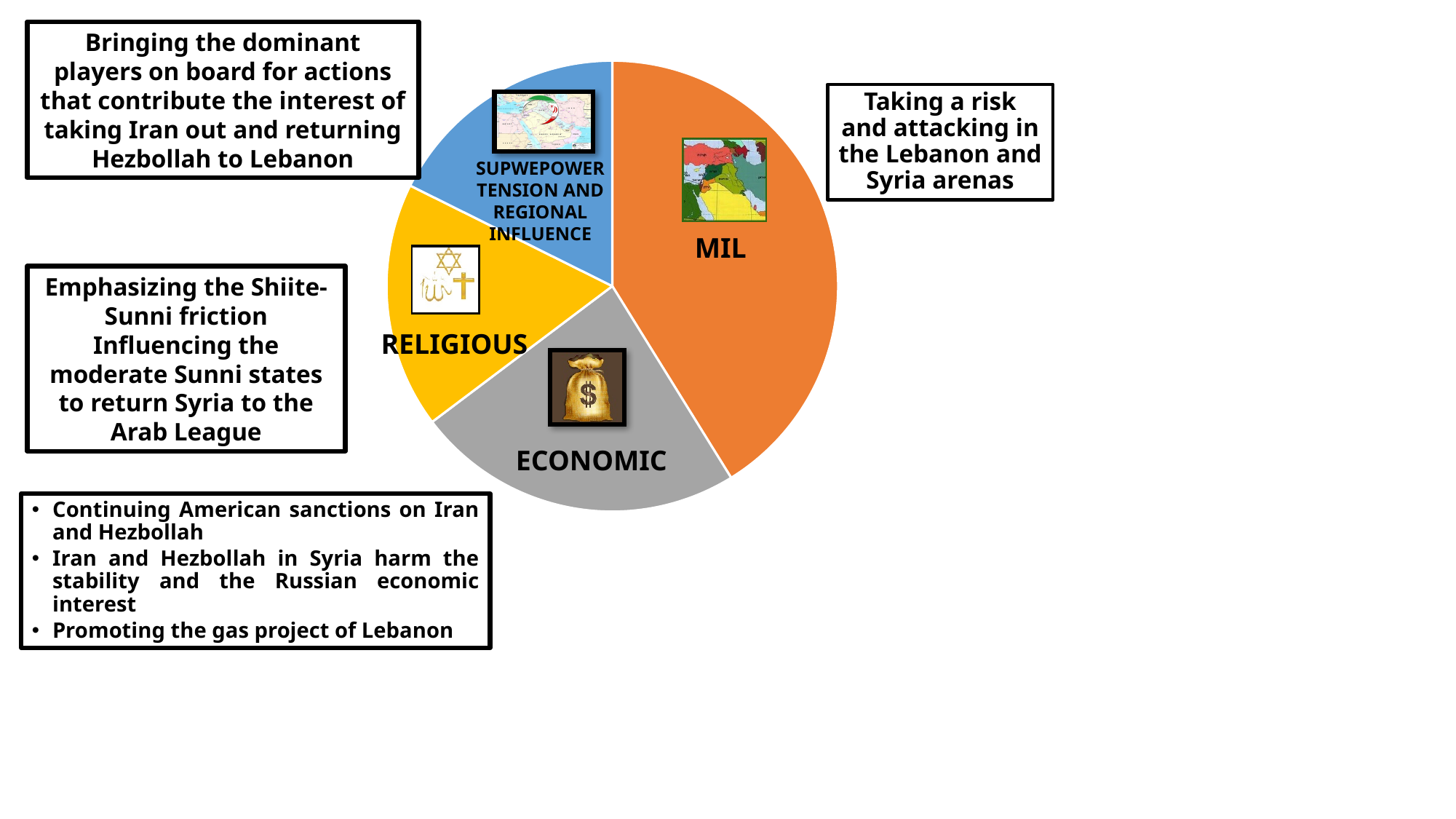
Which slice is larger, MIL or SUPWEPOWER TENSION AND REGIONAL INFLUENCE? MIL What colour is the MIL slice of the pie chart? orange How many slices does the pie chart have? 4 Which slice of the pie chart is the largest? MIL Which slice is larger, MIL or RELIGIOUS? MIL What colour is the ECONOMIC slice of the pie chart? gray Which slice is larger, ECONOMIC or RELIGIOUS? ECONOMIC What kind of chart is shown on the slide? pie chart